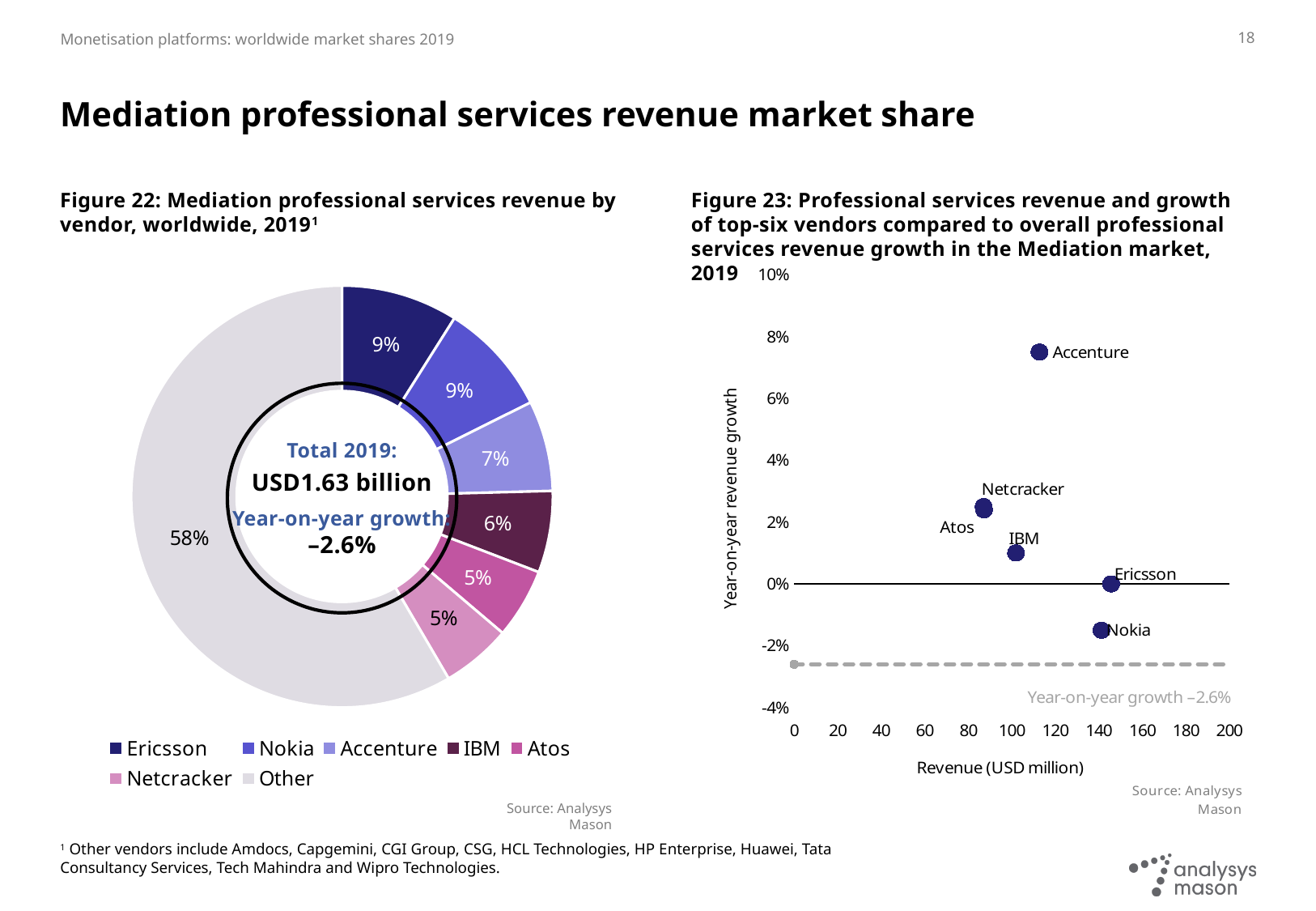
In Figure 23, is Ericsson's revenue greater or less than 120 USD million? greater In Figure 23, is Accenture's year-on-year revenue growth greater or less than 6%? greater In Figure 23, which vendor has the highest year-on-year revenue growth? Accenture In Figure 22, how many percentage points larger is Accenture's share than IBM's? 1 percentage point In Figure 22, what is the total 2019 revenue shown in the centre of the chart? USD1.63 billion In Figure 22, what share is labelled for Other vendors? 58% In Figure 22, what share of mediation professional services revenue does Ericsson hold? 9% In Figure 22, which segment is the largest? Other In Figure 22, what is IBM's share? 6% What kind of chart is Figure 22? doughnut chart In Figure 22, how many vendor categories does the legend list? 7 What kind of chart is Figure 23? scatter chart